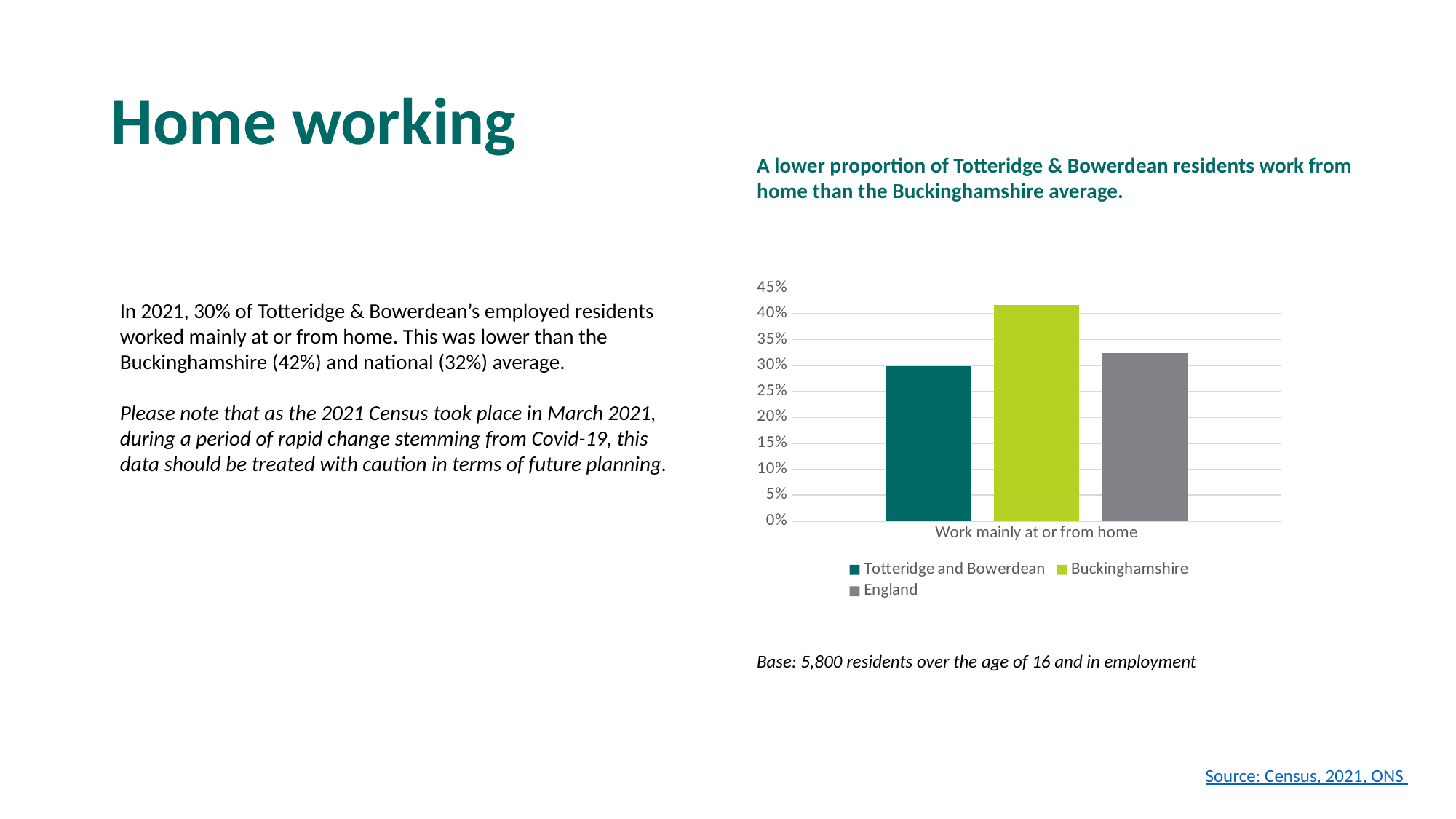
How many series does the chart legend list? 3 Is the value for England greater or less than 30%? greater How many categories are shown on the x axis of the chart? 1 What type of chart is shown on the slide? bar chart What is the value for Totteridge and Bowerdean for 'Work mainly at or from home'? 30% Which series has the highest value for 'Work mainly at or from home'? Buckinghamshire Is the value for Buckinghamshire greater or less than 45%? less Which series has the lowest value for 'Work mainly at or from home'? Totteridge and Bowerdean Which series is shown in grey in the chart? England Which is larger, the value for England or the value for Totteridge and Bowerdean? England What is the category label shown on the x axis of the chart? Work mainly at or from home Is the value for Buckinghamshire greater or less than 40%? greater